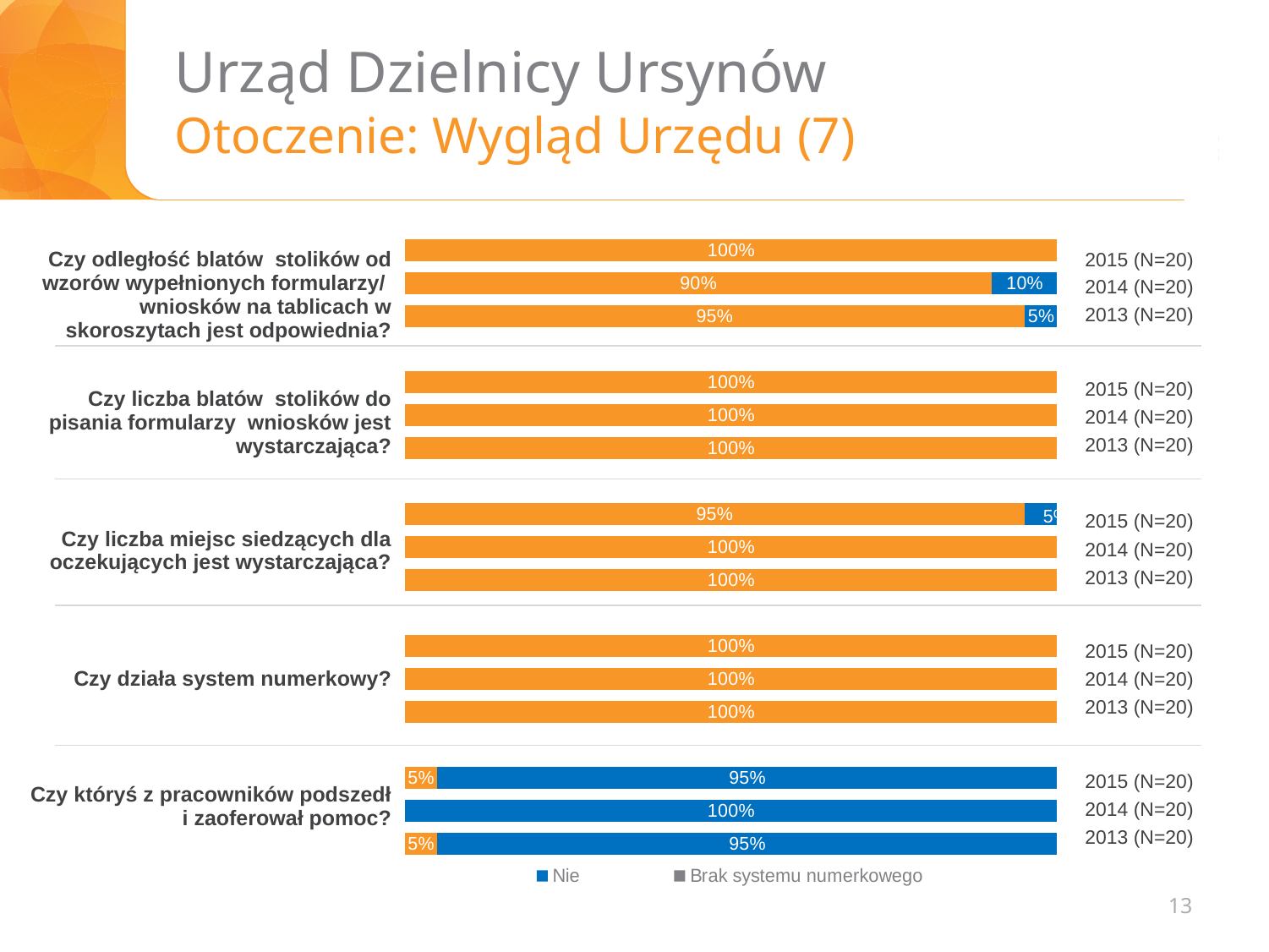
In the chart for "Czy liczba miejsc siedzących dla oczekujących jest wystarczająca?", what is the orange value for 2015 (N=20)? 95% In the chart for "Czy odległość blatów stolików od wzorów wypełnionych formularzy/wniosków na tablicach w skoroszytach jest odpowiednia?", what is the orange value for 2014 (N=20)? 90% In the chart for "Czy któryś z pracowników podszedł i zaoferował pomoc?", what is the blue (Nie) value for 2014 (N=20)? 100% In the chart for "Czy odległość blatów stolików od wzorów wypełnionych formularzy/wniosków na tablicach w skoroszytach jest odpowiednia?", what is the difference between the orange values for 2015 and 2014? 10 percentage points How many bars (years) does the chart for "Czy liczba blatów stolików do pisania formularzy wniosków jest wystarczająca?" show? 3 In the chart for "Czy odległość blatów stolików od wzorów wypełnionych formularzy/wniosków na tablicach w skoroszytach jest odpowiednia?", what is the blue (Nie) value for 2014 (N=20)? 10% In the chart for "Czy któryś z pracowników podszedł i zaoferował pomoc?", is the orange value for 2015 larger or the blue value for 2015? blue (95%) What kind of chart is used on this slide? Stacked horizontal bar chart In the chart for "Czy odległość blatów stolików od wzorów wypełnionych formularzy/wniosków na tablicach w skoroszytach jest odpowiednia?", which year has the lowest orange value? 2014 (N=20) In the chart for "Czy któryś z pracowników podszedł i zaoferował pomoc?", what is the blue (Nie) value for 2015 (N=20)? 95% In the chart for "Czy odległość blatów stolików od wzorów wypełnionych formularzy/wniosków na tablicach w skoroszytach jest odpowiednia?", what is the blue (Nie) value for 2013 (N=20)? 5% In the chart for "Czy działa system numerkowy?", what is the value shown for 2013 (N=20)? 100%